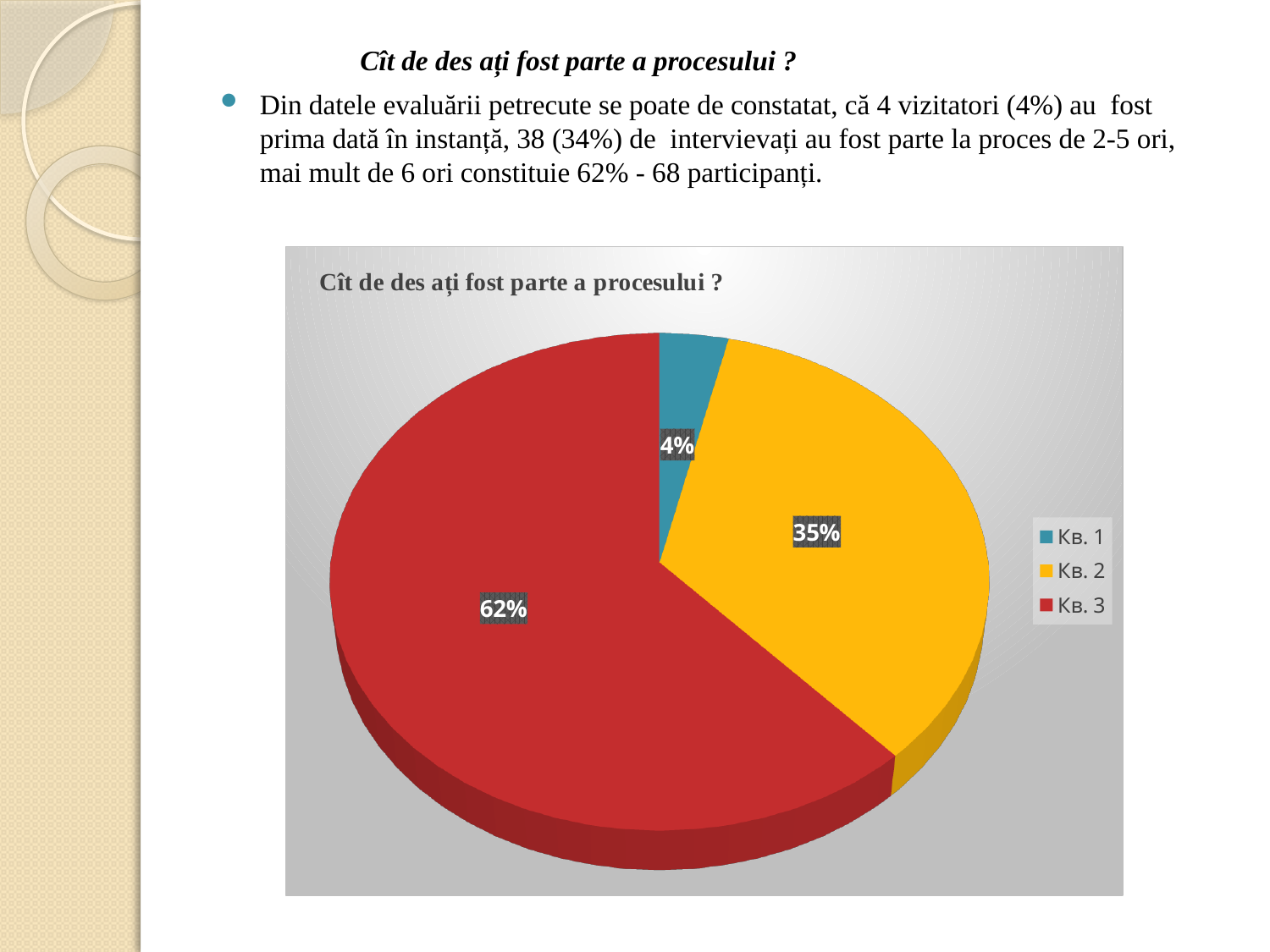
Which slice is the largest in the pie chart? Кв. 3 What is the difference in percentage points between Кв. 3 and Кв. 2? 27% What colour is the slice for Кв. 3? red Which slice is the smallest in the pie chart? Кв. 1 Which is larger, the share for Кв. 2 or the share for Кв. 1? Кв. 2 How many entries does the legend list? 3 What kind of chart is shown on the slide? pie chart What share of the pie does Кв. 3 represent? 62% How many slices does the pie chart have? 3 What is the title of the chart? Cît de des ați fost parte a procesului ? What share of the pie does Кв. 2 represent? 35% What share of the pie does Кв. 1 represent? 4%